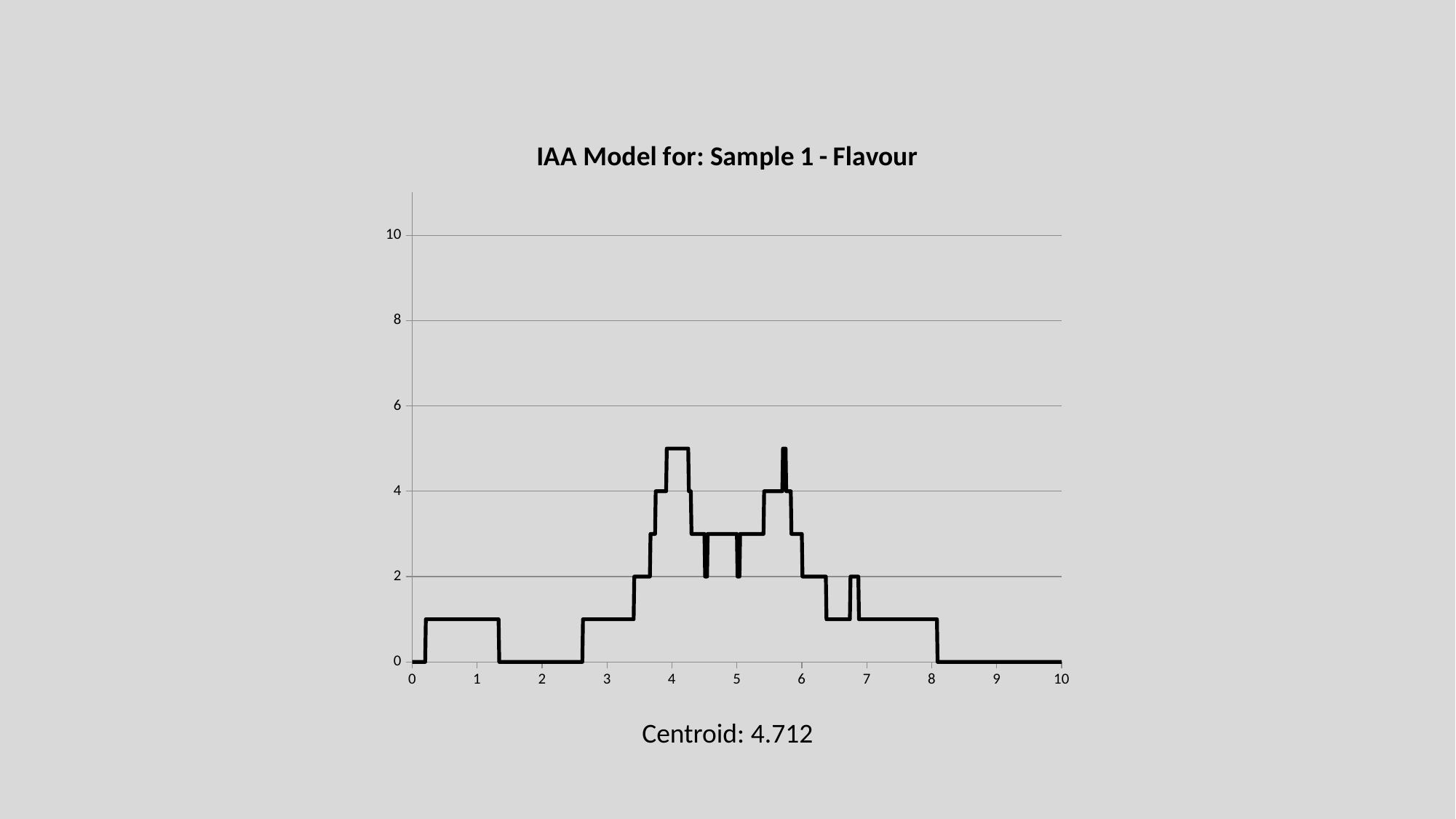
Does the line rise or fall as x goes from 2.5 to 4? rise Does the line rise or fall as x goes from 6 to 8? fall What is the value of the line at x = 9? 0 What is the value of the line at x = 6.2? 2 Is the value of the line at x = 7.5 greater or less than 2? less Is the highest value reached by the line greater or less than 4? greater What is the value of the line at x = 2? 0 What kind of chart is shown on the slide? line chart What centroid value is printed below the chart? 4.712 What is the title of the chart? IAA Model for: Sample 1 - Flavour What is the value of the line at x = 3.5? 2 Is the value of the line at x = 1 greater or less than 2? less